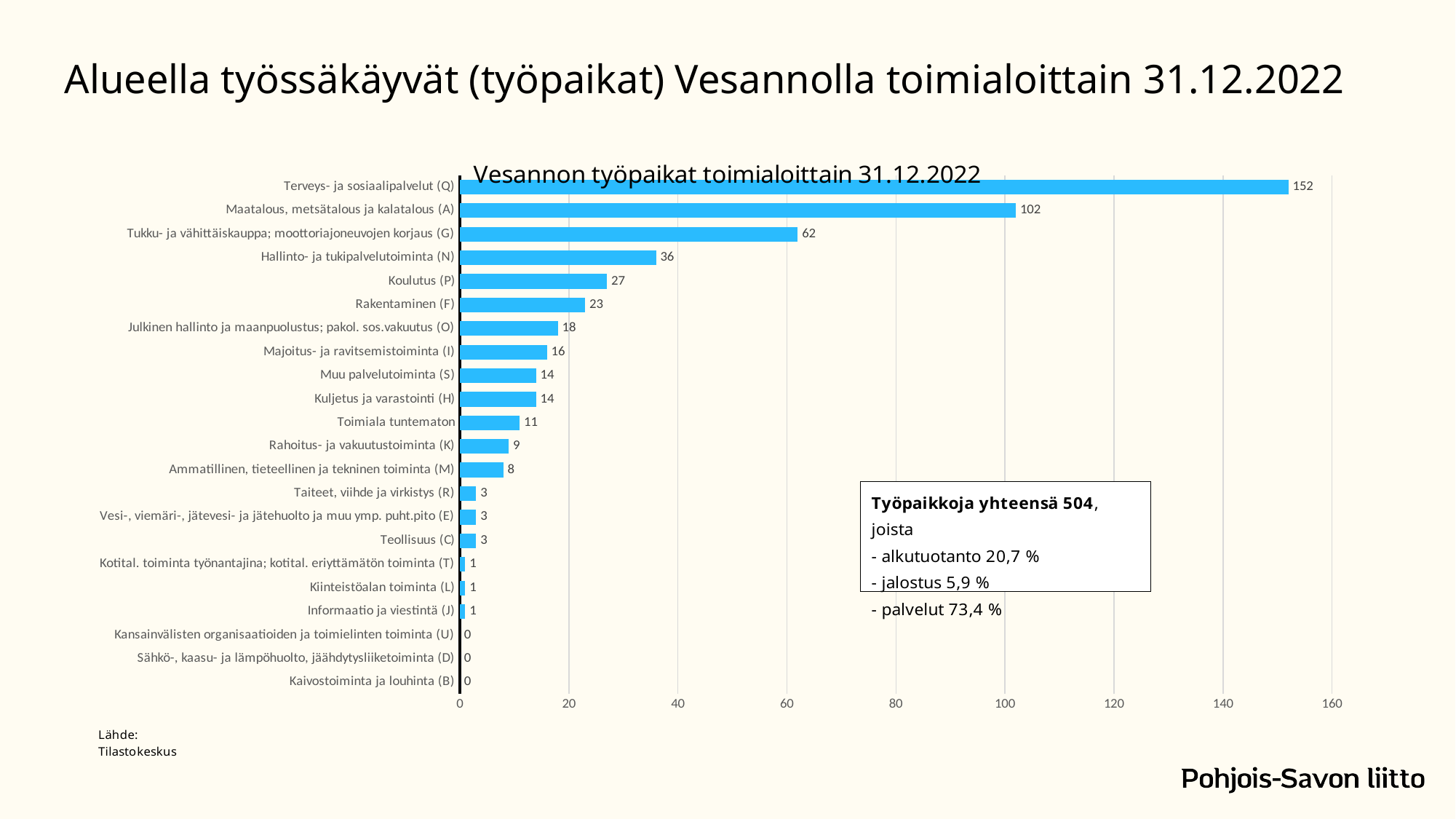
What is the value for Koulutus (P)? 27 Which category has the highest value? Terveys- ja sosiaalipalvelut (Q) What is the value for Maatalous, metsätalous ja kalatalous (A)? 102 Which is larger, the value for Rakentaminen (F) or the value for Majoitus- ja ravitsemistoiminta (I)? Rakentaminen (F) What kind of chart is shown on the slide? Bar chart What is the difference between the values for Tukku- ja vähittäiskauppa; moottoriajoneuvojen korjaus (G) and Hallinto- ja tukipalvelutoiminta (N)? 26 What is the value for Rahoitus- ja vakuutustoiminta (K)? 9 How many categories are shown in the chart? 22 Is the value for Tukku- ja vähittäiskauppa; moottoriajoneuvojen korjaus (G) greater or less than 60? greater What is the title of the chart? Vesannon työpaikat toimialoittain 31.12.2022 What is the difference between the values for Terveys- ja sosiaalipalvelut (Q) and Maatalous, metsätalous ja kalatalous (A)? 50 What is the value for Terveys- ja sosiaalipalvelut (Q)? 152